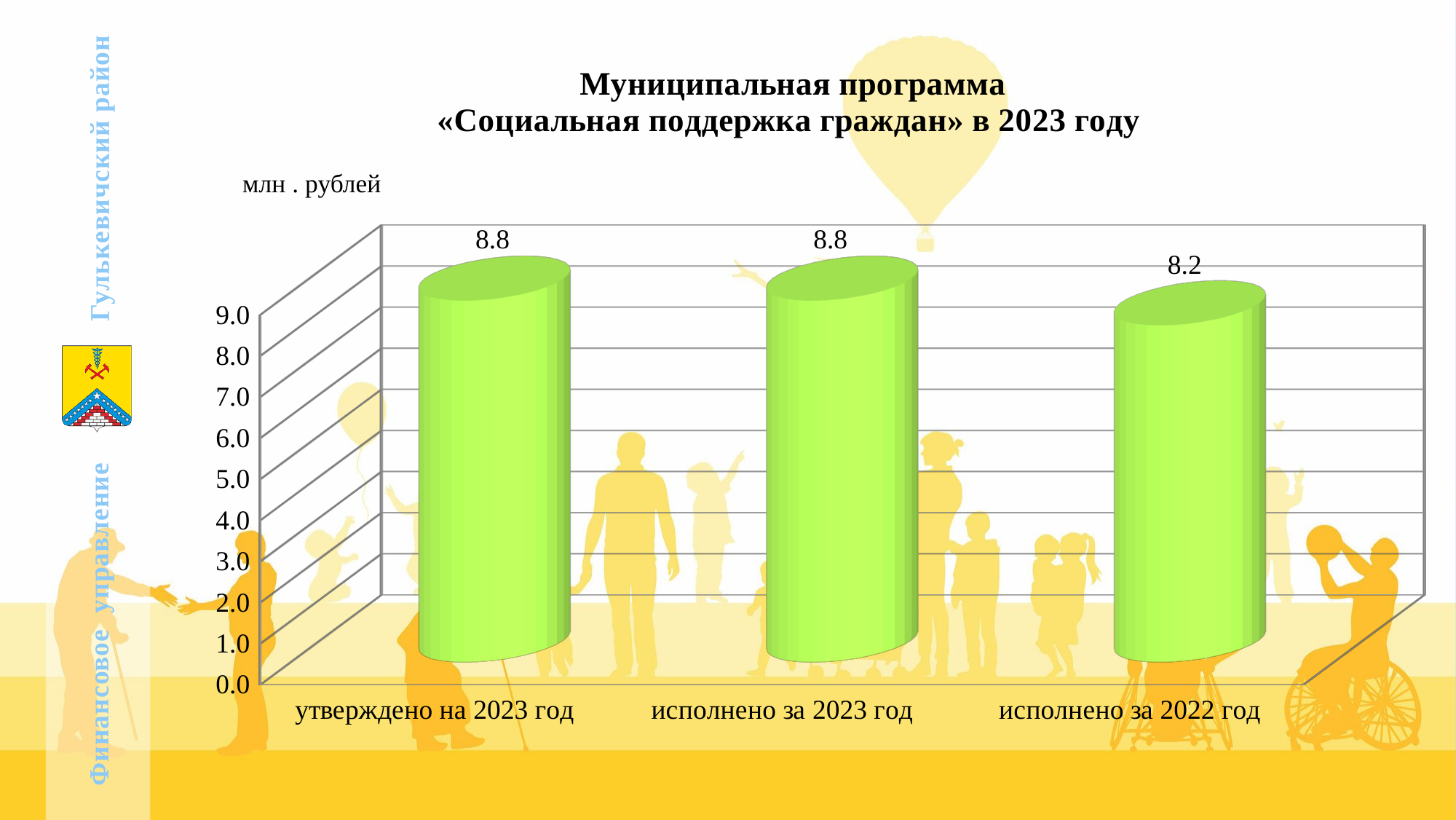
Which is larger: the value for «утверждено на 2023 год» or the value for «исполнено за 2022 год»? утверждено на 2023 год What is the value for «исполнено за 2023 год»? 8.8 What is the value for «исполнено за 2022 год»? 8.2 What is the difference between the value for «исполнено за 2023 год» and the value for «исполнено за 2022 год»? 0.6 Which category has the lowest value? исполнено за 2022 год What is the value for «утверждено на 2023 год»? 8.8 Is the value for «утверждено на 2023 год» greater or less than 9.0? less What kind of chart is shown on the slide? bar chart Is the value for «исполнено за 2022 год» greater or less than 8.0? greater In what units are the values on the chart expressed? млн. рублей How many categories are shown on the chart? 3 Do the values rise or fall from the first category to the last category along the x axis? fall